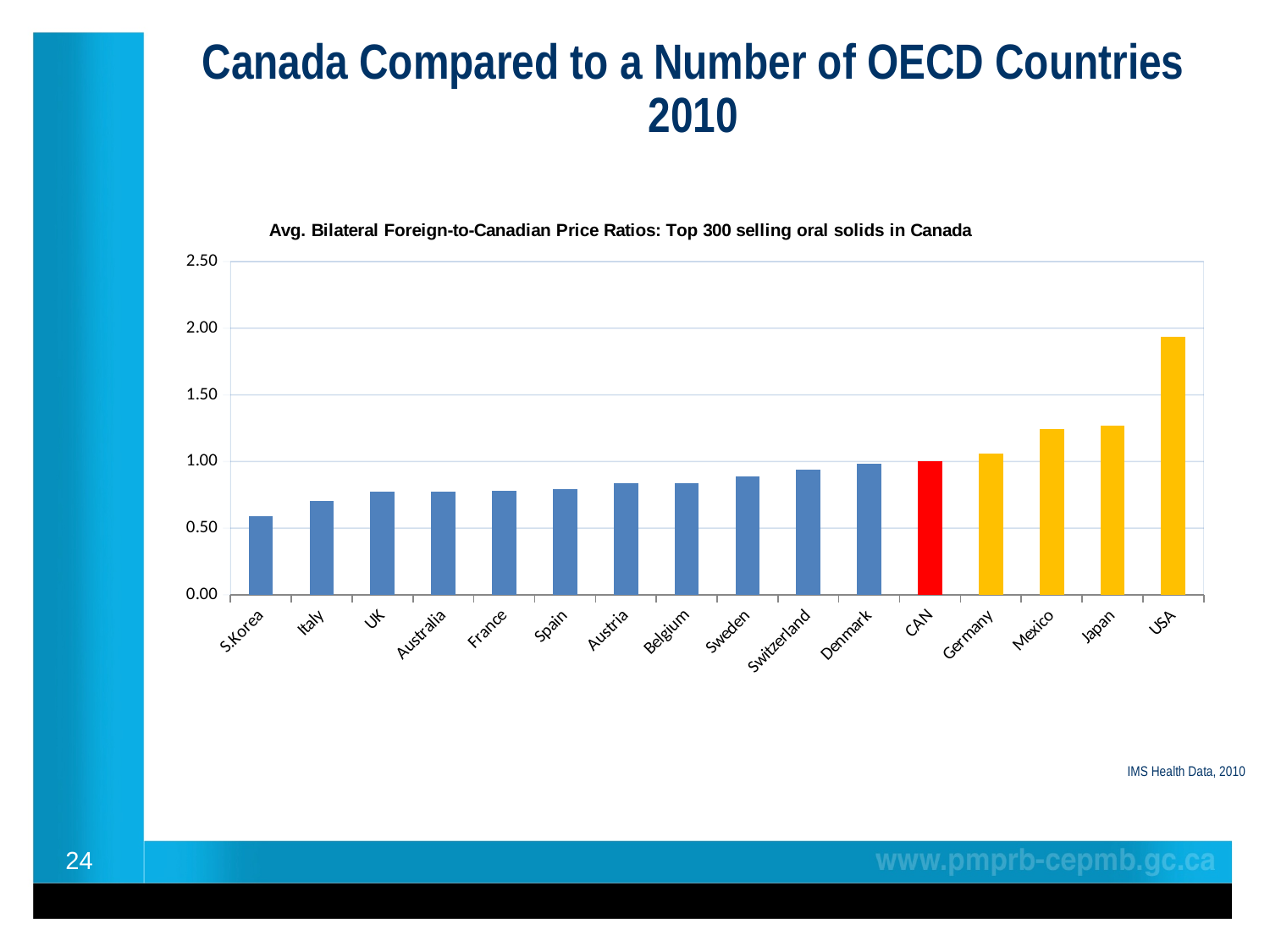
Is the value for Mexico greater or less than 1.00? greater Which country has the lowest average bilateral foreign-to-Canadian price ratio? S.Korea How many countries are plotted on the chart? 16 Is the value for Italy greater or less than 1.00? less What kind of chart is shown on the slide? bar chart Which has the larger value, USA or Japan? USA Do the values rise or fall moving from left to right along the x axis? rise Which country has the highest average bilateral foreign-to-Canadian price ratio? USA What colour is the bar for CAN? red Is the value for Japan greater or less than 1.50? less What is the price ratio value for CAN? 1.00